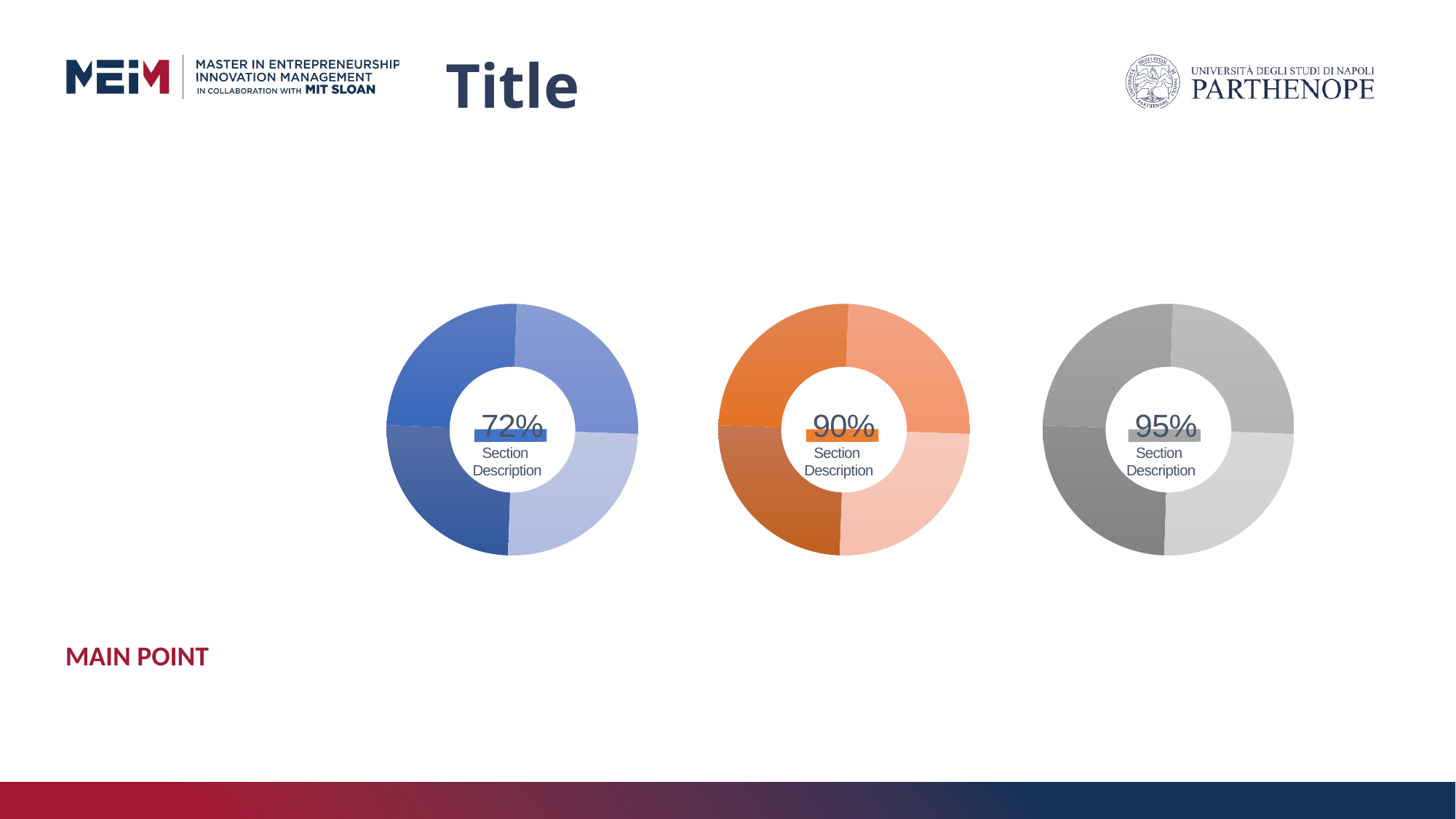
Which of the three doughnut charts shows the highest percentage in its centre? The right (grey) chart, 95% What percentage is printed in the centre of the right (grey) doughnut chart? 95% What percentage is printed in the centre of the left (blue) doughnut chart? 72% Which of the three doughnut charts shows the lowest percentage in its centre? The left (blue) chart, 72% What percentage is printed in the centre of the middle (orange) doughnut chart? 90% How many segments does the left (blue) doughnut chart have? 4 What is the difference between the percentages printed in the centres of the right (grey) and left (blue) doughnut charts? 23% How many doughnut charts are shown on the slide? 3 Is the percentage in the centre of the middle (orange) chart larger or smaller than the one in the left (blue) chart? Larger What colour scheme is used for the middle doughnut chart? Orange What text appears below the percentage in the centre of each doughnut chart? Section Description What kind of chart is the left chart on the slide? Doughnut chart